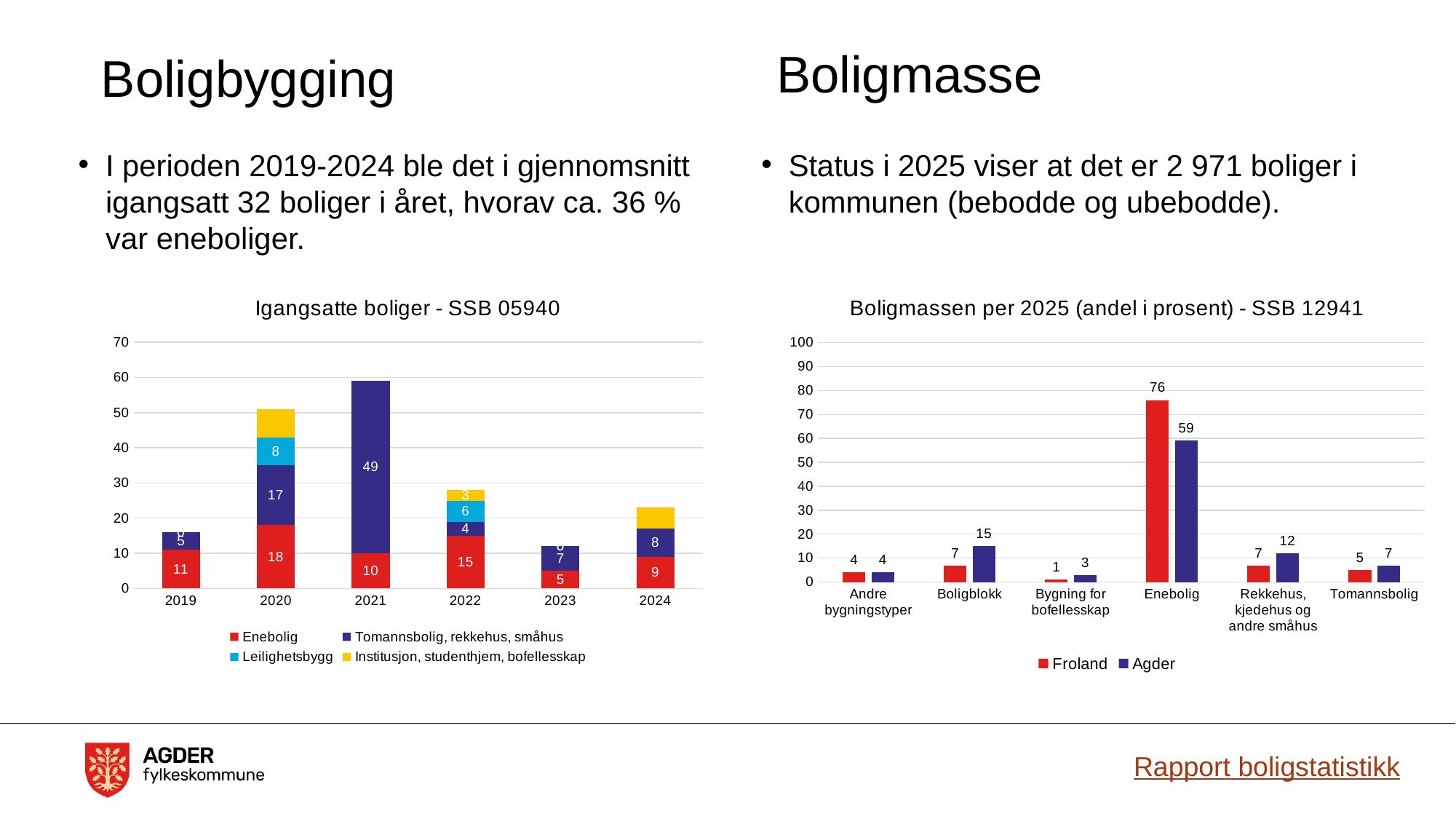
In the chart 'Boligmassen per 2025 (andel i prosent) - SSB 12941', which is larger for Rekkehus, kjedehus og andre småhus: Froland or Agder? Agder What kind of chart is 'Boligmassen per 2025 (andel i prosent) - SSB 12941'? Bar chart In the chart 'Igangsatte boliger - SSB 05940', what is the value for Tomannsbolig, rekkehus, småhus in 2021? 49 In the chart 'Boligmassen per 2025 (andel i prosent) - SSB 12941', which category has the lowest value for Froland? Bygning for bofellesskap In the chart 'Igangsatte boliger - SSB 05940', how many series does the legend list? 4 In the chart 'Boligmassen per 2025 (andel i prosent) - SSB 12941', how many categories are shown on the x axis? 6 In the chart 'Igangsatte boliger - SSB 05940', what is the total of the stacked bar for 2022? 28 In the chart 'Boligmassen per 2025 (andel i prosent) - SSB 12941', what is the value for Froland for Enebolig? 76 In the chart 'Igangsatte boliger - SSB 05940', which year has the highest stacked bar? 2021 In the chart 'Boligmassen per 2025 (andel i prosent) - SSB 12941', what is the difference between Froland and Agder for Boligblokk? 8 In the chart 'Igangsatte boliger - SSB 05940', what is the value for Enebolig in 2020? 18